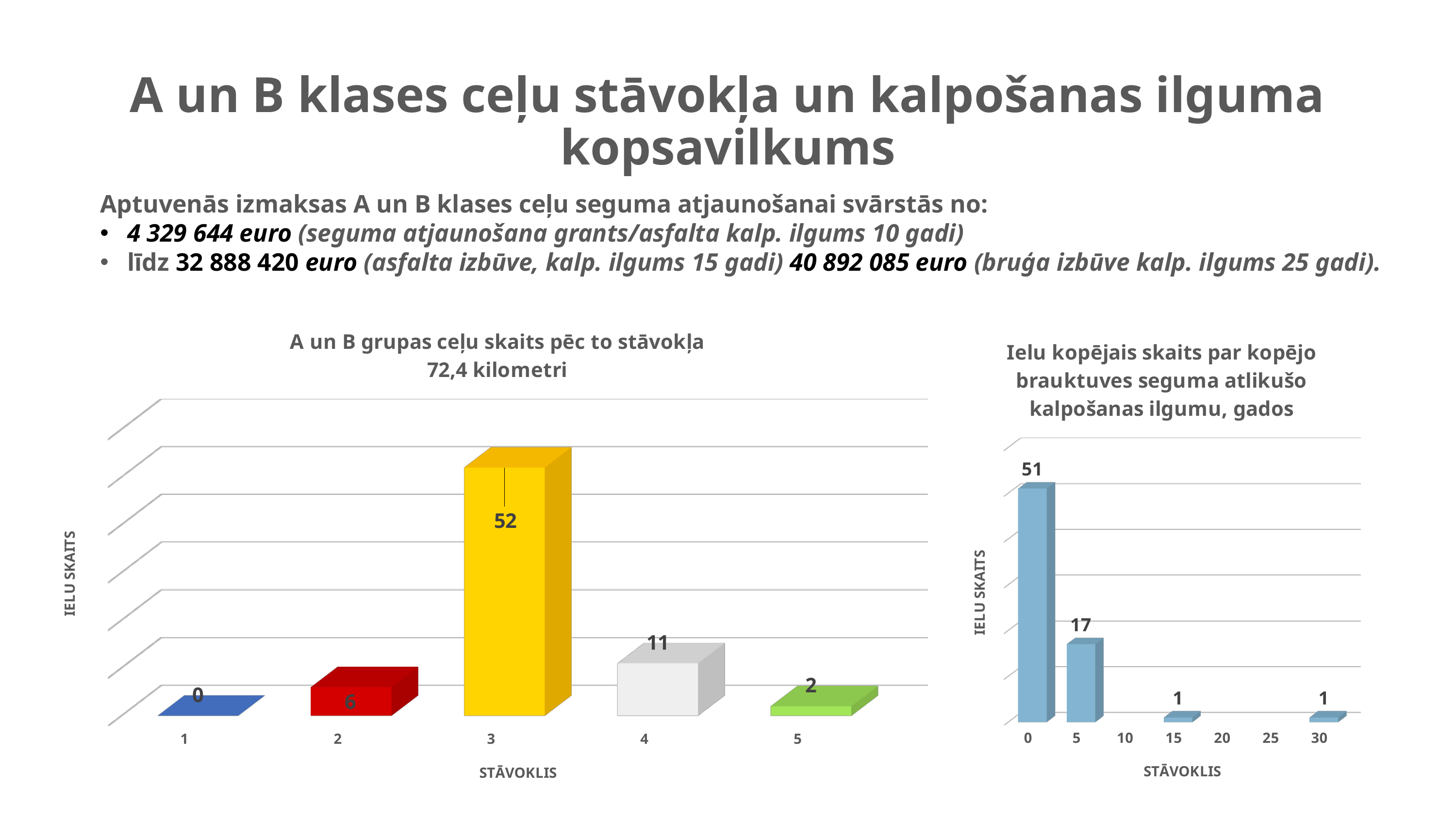
In the left chart 'A un B grupas ceļu skaits pēc to stāvokļa 72,4 kilometri', what is the difference between the values for category 3 and category 4? 41 In the right chart 'Ielu kopējais skaits par kopējo brauktuves seguma atlikušo kalpošanas ilgumu, gados', what is the value for category 5? 17 In the left chart 'A un B grupas ceļu skaits pēc to stāvokļa 72,4 kilometri', which category has the lowest value? 1 In the right chart 'Ielu kopējais skaits par kopējo brauktuves seguma atlikušo kalpošanas ilgumu, gados', what is the difference between the values for category 0 and category 5? 34 In the left chart 'A un B grupas ceļu skaits pēc to stāvokļa 72,4 kilometri', what is the value for category 3? 52 In the left chart 'A un B grupas ceļu skaits pēc to stāvokļa 72,4 kilometri', which is larger, the value for category 2 or category 5? Category 2 What type of chart is the right chart 'Ielu kopējais skaits par kopējo brauktuves seguma atlikušo kalpošanas ilgumu, gados'? Bar chart In the left chart 'A un B grupas ceļu skaits pēc to stāvokļa 72,4 kilometri', which category has the highest value? 3 How many categories are shown on the x axis of the left chart 'A un B grupas ceļu skaits pēc to stāvokļa 72,4 kilometri'? 5 In the left chart 'A un B grupas ceļu skaits pēc to stāvokļa 72,4 kilometri', what is the value for category 4? 11 In the right chart 'Ielu kopējais skaits par kopējo brauktuves seguma atlikušo kalpošanas ilgumu, gados', what is the value for category 0? 51 What is the y-axis title of the left chart 'A un B grupas ceļu skaits pēc to stāvokļa 72,4 kilometri'? IELU SKAITS